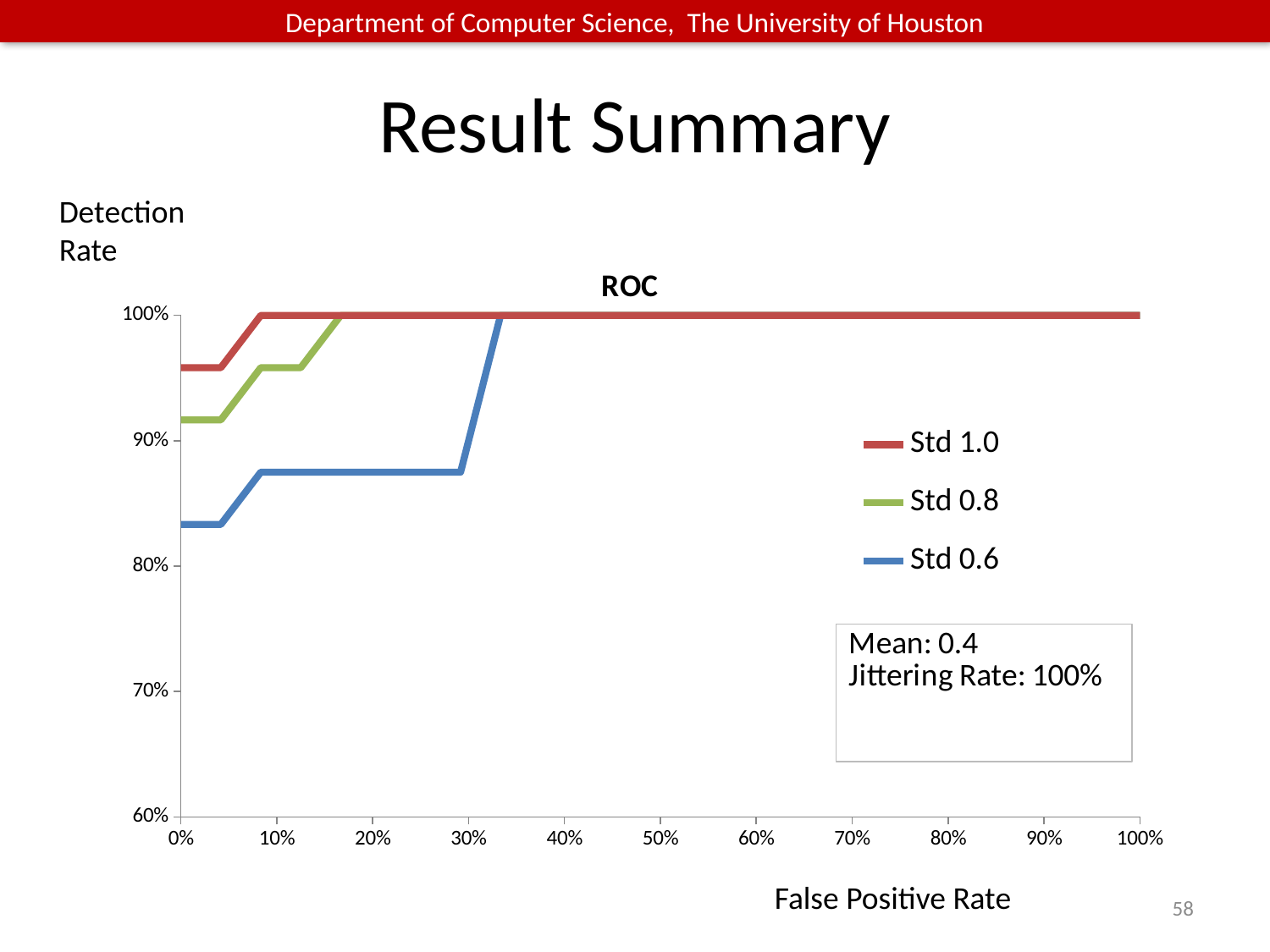
In the ROC chart, which series has the lowest detection rate at 0% false positive rate? Std 0.6 In the ROC chart, is the detection rate for Std 0.8 at 20% false positive rate greater or less than 90%? greater In the ROC chart, is the detection rate for Std 1.0 at 0% false positive rate greater or less than 90%? greater In the ROC chart, which series has the highest detection rate at 0% false positive rate? Std 1.0 In the ROC chart, does the detection rate for Std 0.6 rise or fall as the false positive rate increases from 0% to 40%? rise In the ROC chart, is the detection rate for Std 0.6 at 0% false positive rate greater or less than 90%? less What is the title of the chart? ROC How many series does the legend of the ROC chart list? 3 Which series are listed in the legend of the ROC chart? Std 1.0, Std 0.8, Std 0.6 In the ROC chart, at 20% false positive rate, which series has the higher detection rate, Std 0.8 or Std 0.6? Std 0.8 What kind of chart is shown on the slide? line chart In the ROC chart, what is the detection rate for Std 0.6 at 50% false positive rate? 100%